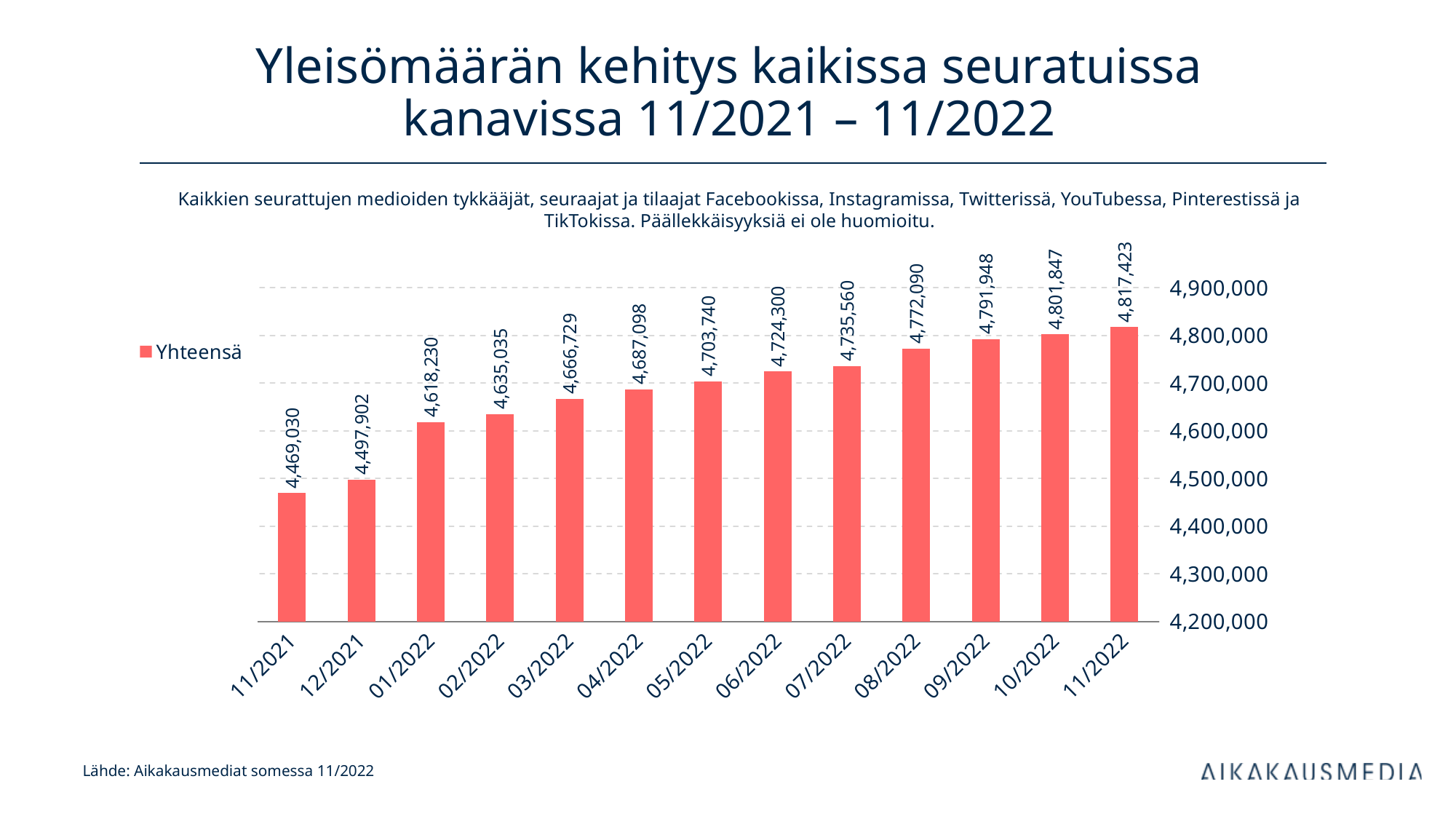
Is the value for 12/2021 greater or less than 4,600,000? less Which month has the highest value? 11/2022 What is the value for 11/2021? 4,469,030 What is the difference between the values for 11/2022 and 11/2021? 348,393 Which is larger, the value for 03/2022 or the value for 08/2022? 08/2022 What is the value for 06/2022? 4,724,300 How many months are shown on the x axis? 13 What is the difference between the values for 01/2022 and 12/2021? 120,328 Which month has the lowest value? 11/2021 What kind of chart is shown on the slide? bar chart What is the value for 11/2022? 4,817,423 Do the values rise or fall from 11/2021 to 11/2022? rise